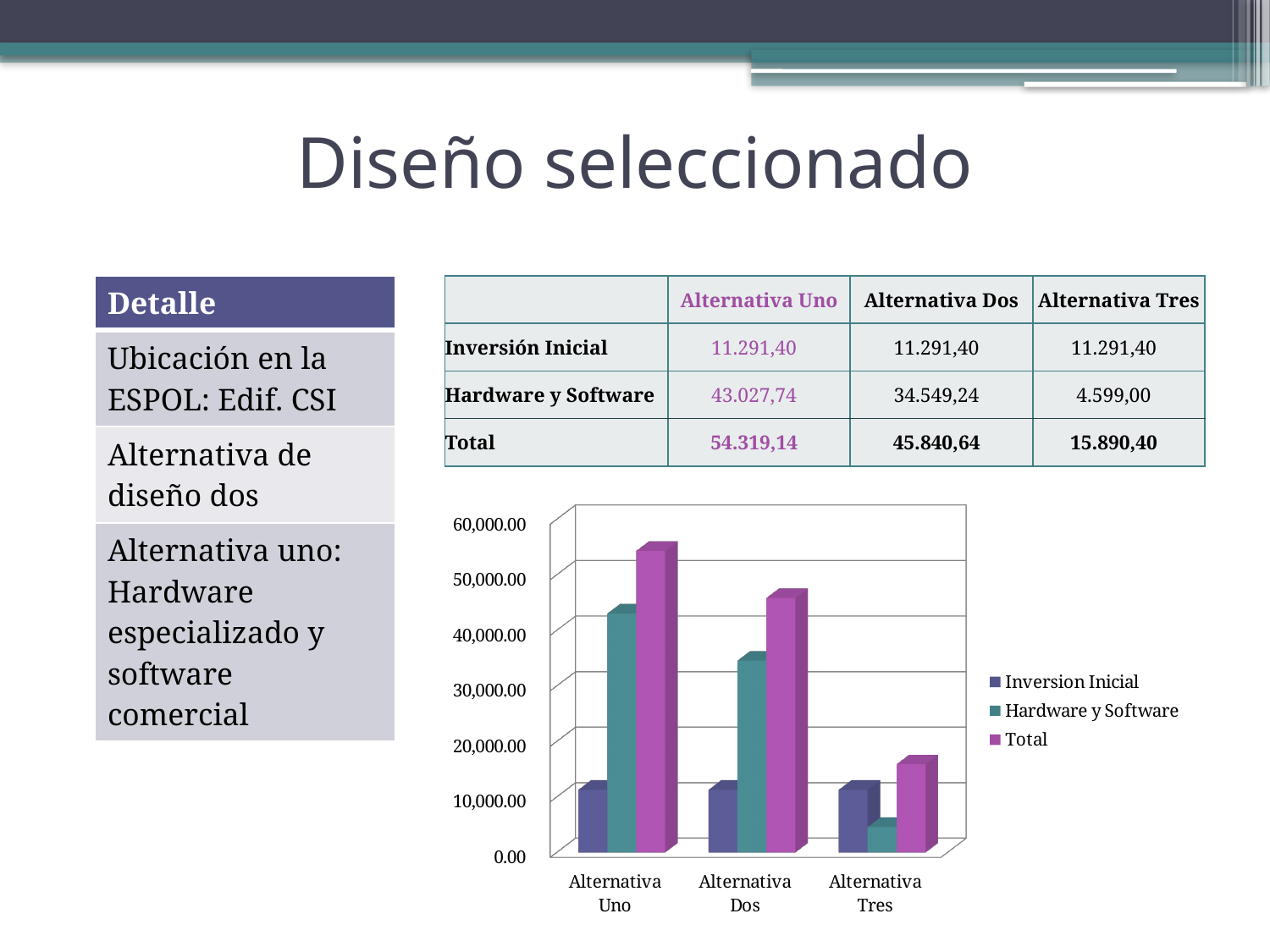
Do the Total bars rise or fall from Alternativa Uno to Alternativa Tres? fall Is the Hardware y Software bar for Alternativa Tres greater or less than 10,000.00? less How many alternatives (categories) are plotted along the x axis of the chart? 3 What kind of chart is shown on the slide? bar chart How many series does the chart legend list? 3 Which series in the chart legend is shown in purple/magenta? Total Which is larger in the chart: the Hardware y Software bar for Alternativa Dos or for Alternativa Tres? Alternativa Dos According to the table on the slide, what is the Total for Alternativa Dos? 45.840,64 Which alternative has the highest Total bar in the chart? Alternativa Uno Is the Total bar for Alternativa Uno greater or less than 50,000.00? greater Using the values in the table, what is the difference between the Total for Alternativa Uno and the Total for Alternativa Tres? 38.428,74 Which alternative has the lowest Hardware y Software bar in the chart? Alternativa Tres